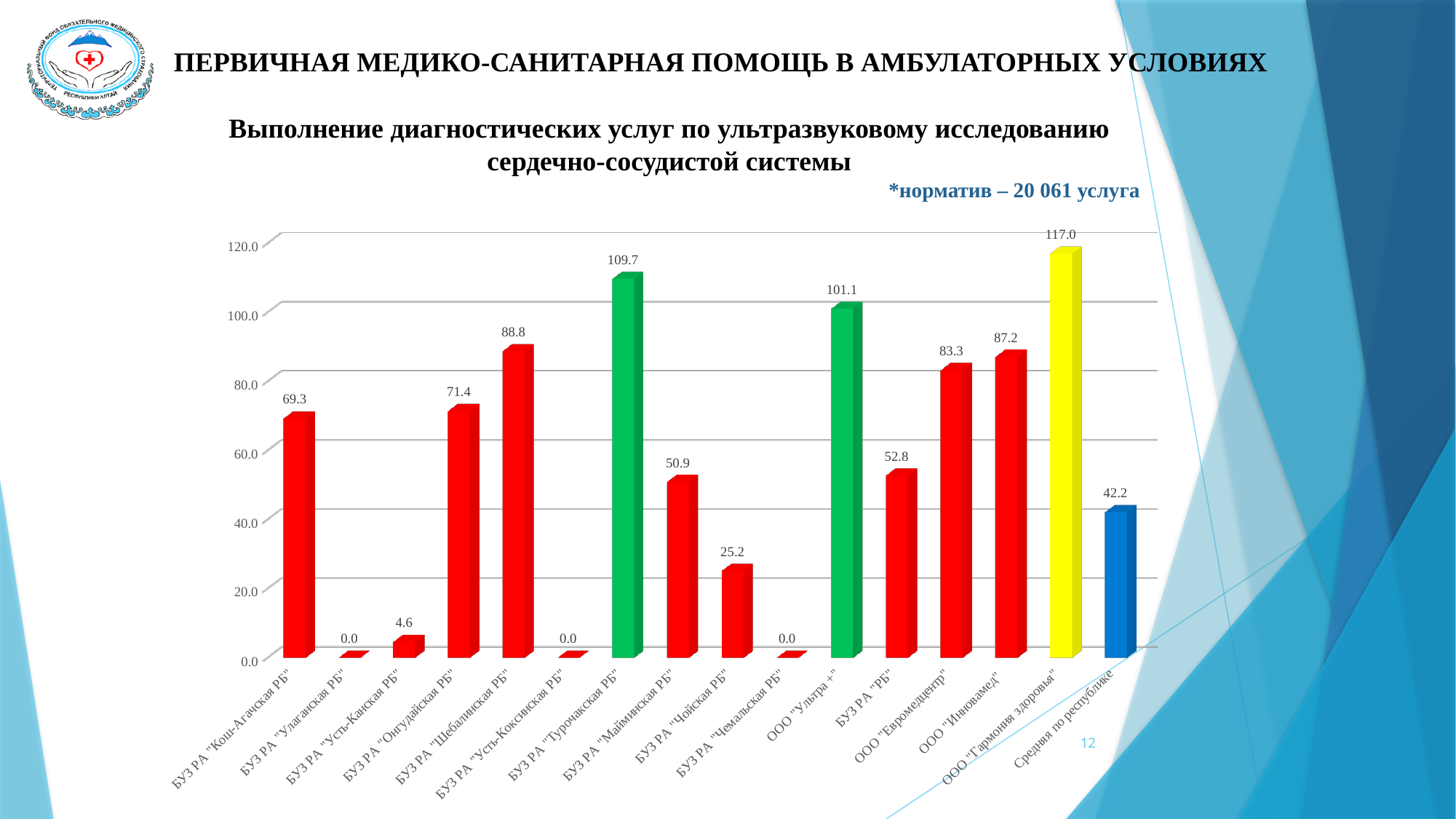
How many categories have a value of 0.0? 3 What value is shown for ООО "Ультра +"? 101.1 What value is shown for БУЗ РА "Чойская РБ"? 25.2 What is the difference between the values for ООО "Гармония здоровья" and БУЗ РА "Турочакская РБ"? 7.3 What kind of chart is shown on the slide? Bar chart What is the value for Средняя по республике? 42.2 What value is shown for БУЗ РА "Шебалинская РБ"? 88.8 How many categories are shown on the x axis? 16 Which category has the highest value? ООО "Гармония здоровья" What is the difference between the values for БУЗ РА "Шебалинская РБ" and БУЗ РА "Онгудайская РБ"? 17.4 Which is larger, the value for БУЗ РА "Турочакская РБ" or for ООО "Ультра +"? БУЗ РА "Турочакская РБ" What norm (норматив) value is stated above the chart? 20 061 услуга